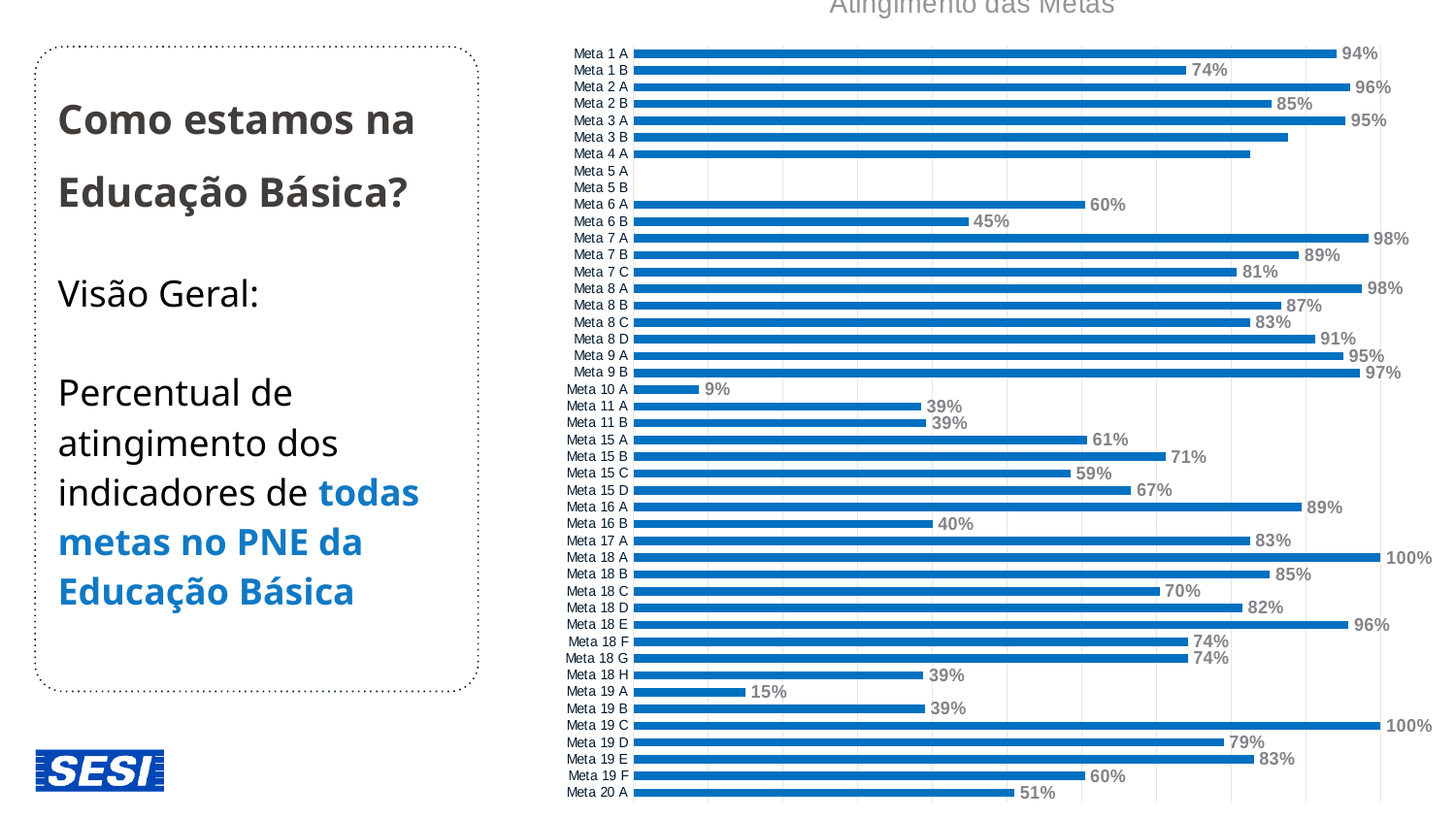
What is the value for Meta 1 A? 94% Which is larger, the value for Meta 15 B or the value for Meta 18 C? Meta 15 B Which category has the lowest labelled value? Meta 10 A What is the value for Meta 15 C? 59% Which two categories reach 100%? Meta 18 A and Meta 19 C What is the title of the chart? Atingimento das Metas What is the difference between the values for Meta 7 A and Meta 6 B? 53 percentage points What is the value for Meta 20 A? 51% Which is larger, the value for Meta 8 D or the value for Meta 16 B? Meta 8 D What kind of chart is shown on the slide? Bar chart What is the value for Meta 10 A? 9% What is the value for Meta 19 A? 15%